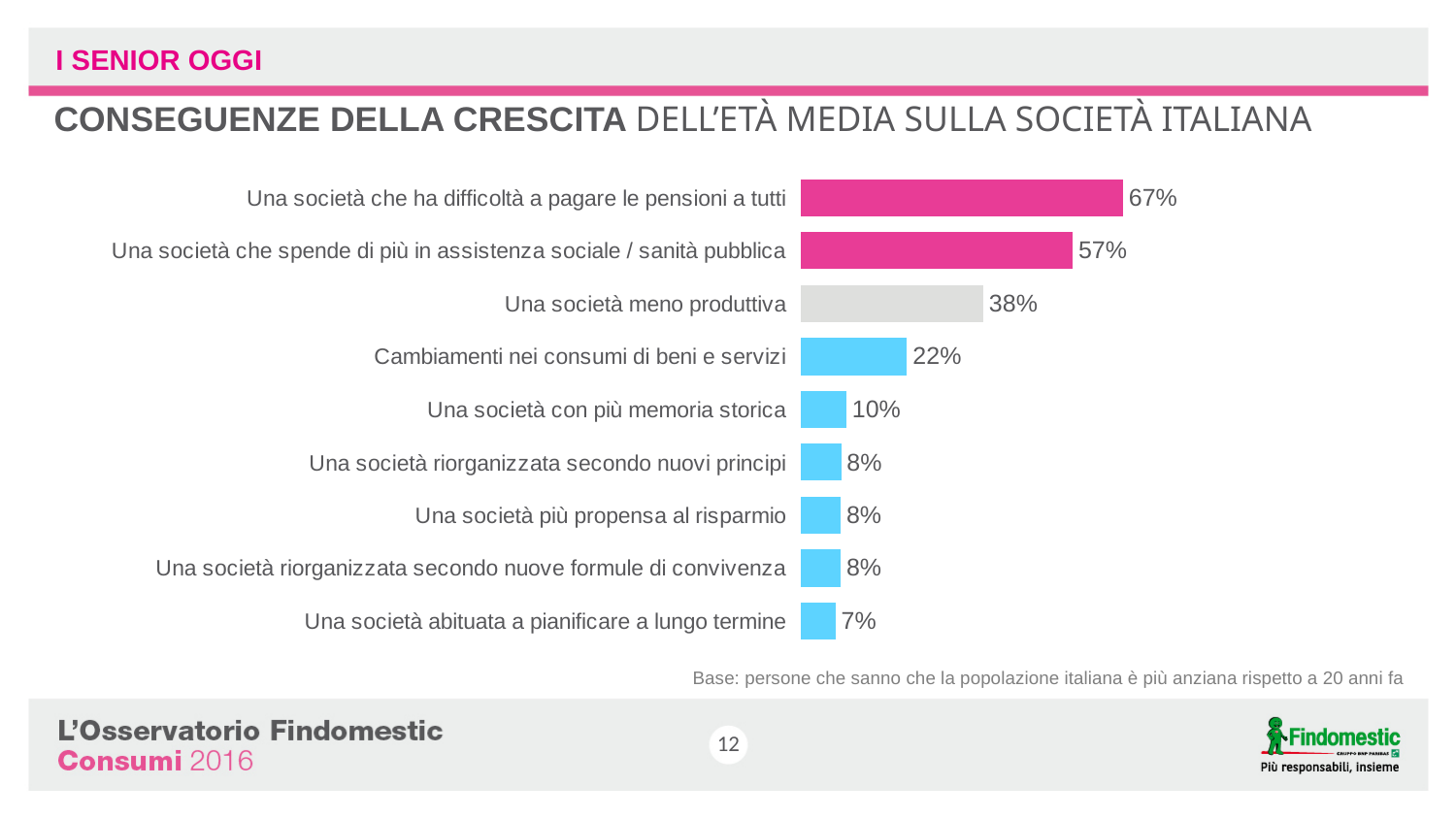
What is the difference between the values for "Una società che ha difficoltà a pagare le pensioni a tutti" and "Una società che spende di più in assistenza sociale / sanità pubblica"? 10% What percentage is shown for "Una società che ha difficoltà a pagare le pensioni a tutti"? 67% What is the difference between the values for "Una società meno produttiva" and "Cambiamenti nei consumi di beni e servizi"? 16% Which category has the highest value? Una società che ha difficoltà a pagare le pensioni a tutti What value is shown for "Una società meno produttiva"? 38% How many categories are shown in the chart? 9 Which is larger: the value for "Una società meno produttiva" or the value for "Una società con più memoria storica"? Una società meno produttiva How many categories share the value 8%? 3 What kind of chart is shown on the slide? Bar chart What percentage is shown for "Cambiamenti nei consumi di beni e servizi"? 22% What value is shown for "Una società con più memoria storica"? 10% Which category has the lowest value? Una società abituata a pianificare a lungo termine